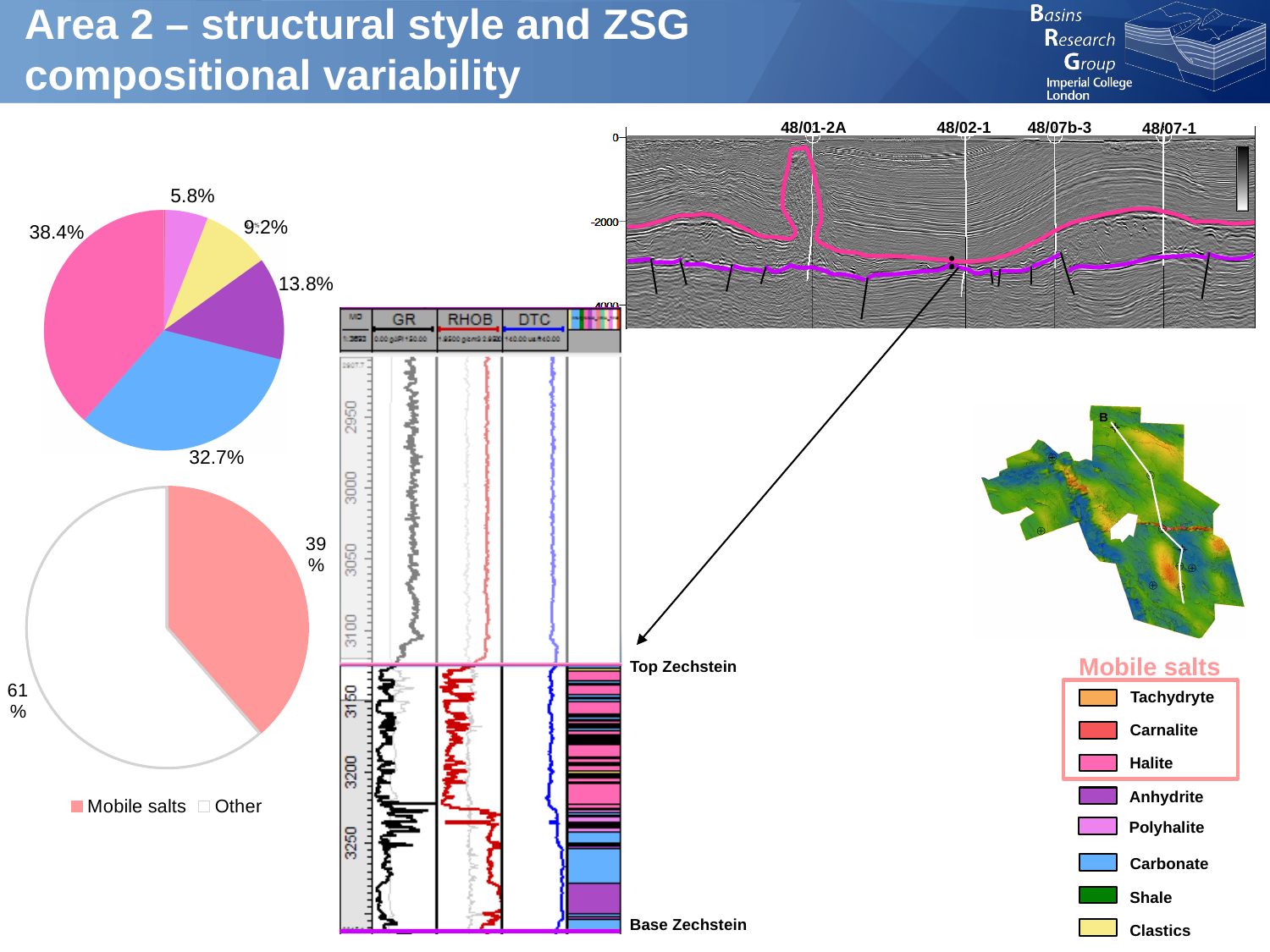
In the upper pie chart, what is the difference between the largest slice (38.4%) and the second largest slice (32.7%)? 5.7 percentage points In the lower pie chart, what is the difference between Other and Mobile salts? 22 percentage points What kind of chart is the lower chart on the left of the slide? Pie chart How many entries does the legend of the lower pie chart list? 2 How many slices does the upper pie chart have? 5 In the lower pie chart, what is the value for Other? 61% In the lower pie chart, which is larger, Mobile salts or Other? Other In the lower pie chart, what is the value for Mobile salts? 39% What kind of chart is the upper chart on the left of the slide? Pie chart In the upper pie chart, what is the value of the yellow slice? 9.2% In the upper pie chart, what is the smallest slice's value? 5.8% In the upper pie chart, what is the largest slice's value? 38.4%